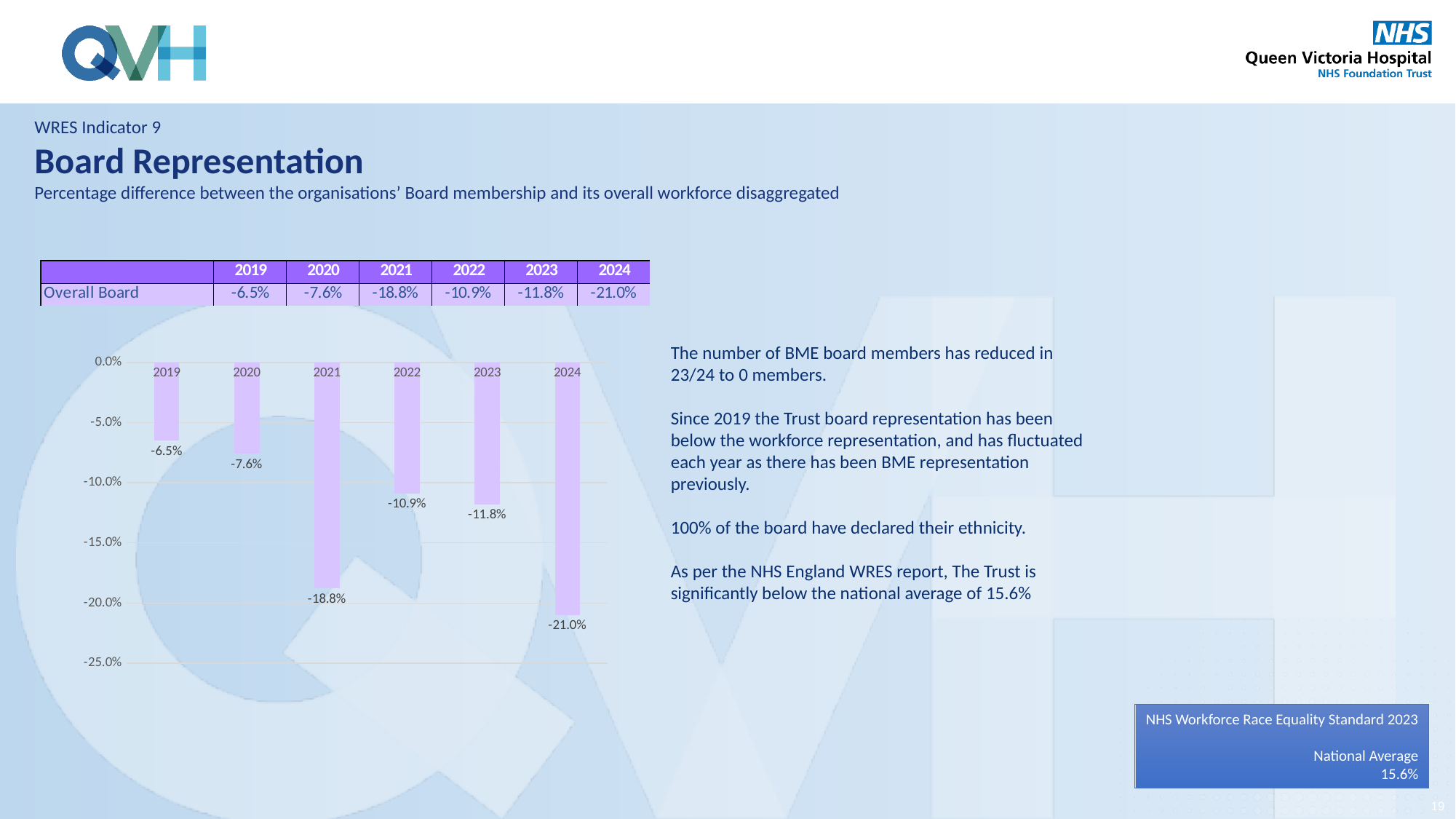
What is the difference in percentage points between the 2019 value and the 2024 value? 14.5 percentage points Which year has the longer bar, 2022 or 2023? 2023 Which year has the most negative value in the bar chart? 2024 What is the value for 2019 in the bar chart? -6.5% What is the value for 2021 in the bar chart? -18.8% From 2022 to 2024, do the values rise or fall? fall What kind of chart is shown on the slide? bar chart How many years are shown in the bar chart? 6 What is the difference in percentage points between the 2020 value and the 2021 value? 11.2 percentage points Which year has the value closest to zero in the bar chart? 2019 What is the value for 2024 in the bar chart? -21.0% Is the value for 2021 greater or less than -15.0%? less